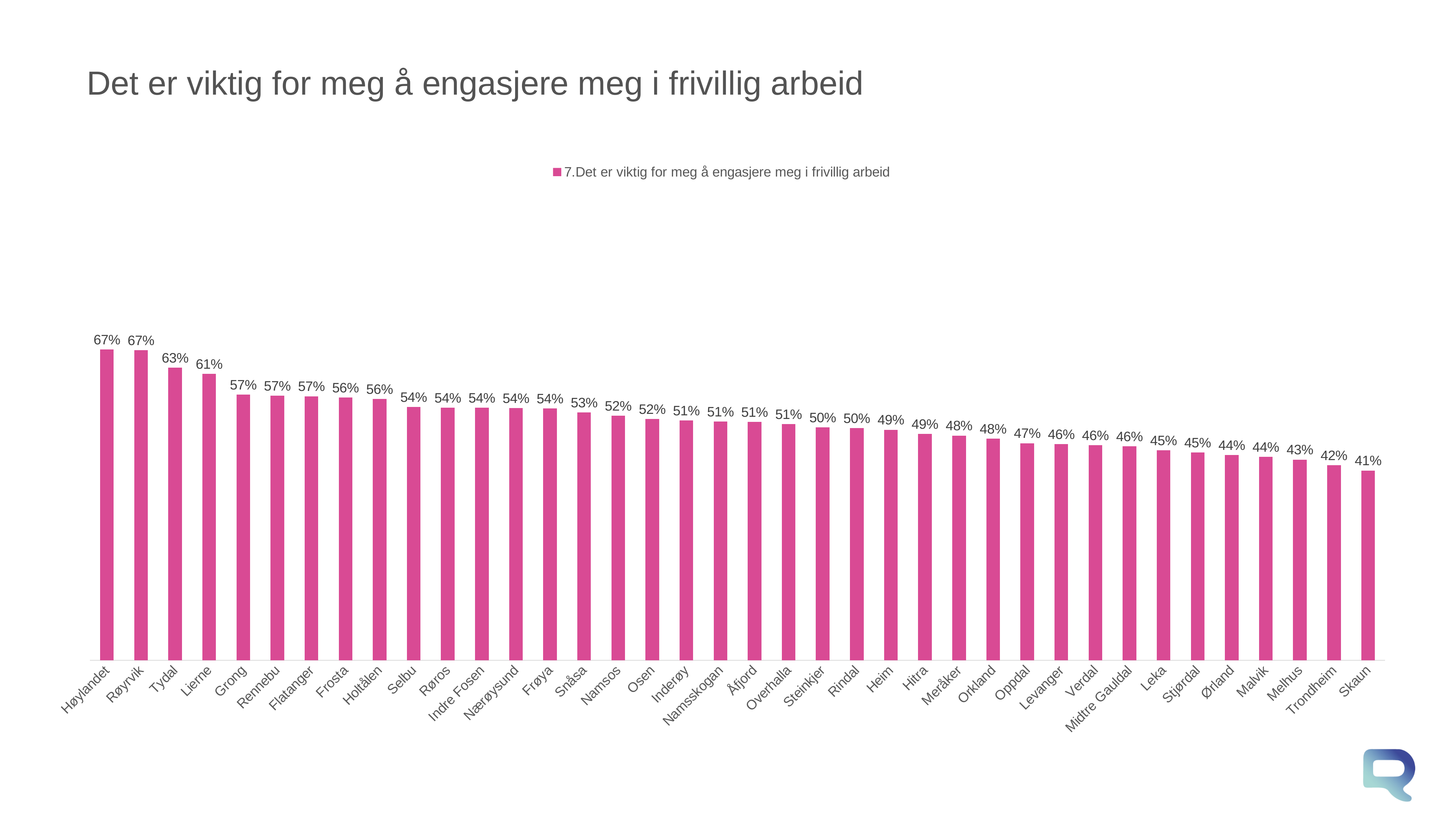
What is the value for Tydal? 63% Which municipality has the lowest value? Skaun What is the value for Midtre Gauldal? 46% What is the value for Trondheim? 42% What kind of chart is shown on the slide? Bar chart What is the difference between the values for Lierne and Skaun? 20% Which is larger, the value for Frosta or the value for Melhus? Frosta How many series does the legend list? 1 What is the value for Snåsa? 53% How many municipalities are shown on the x axis? 38 What is the difference between the values for Tydal and Oppdal? 16% Do the values rise or fall from left to right along the x axis? Fall